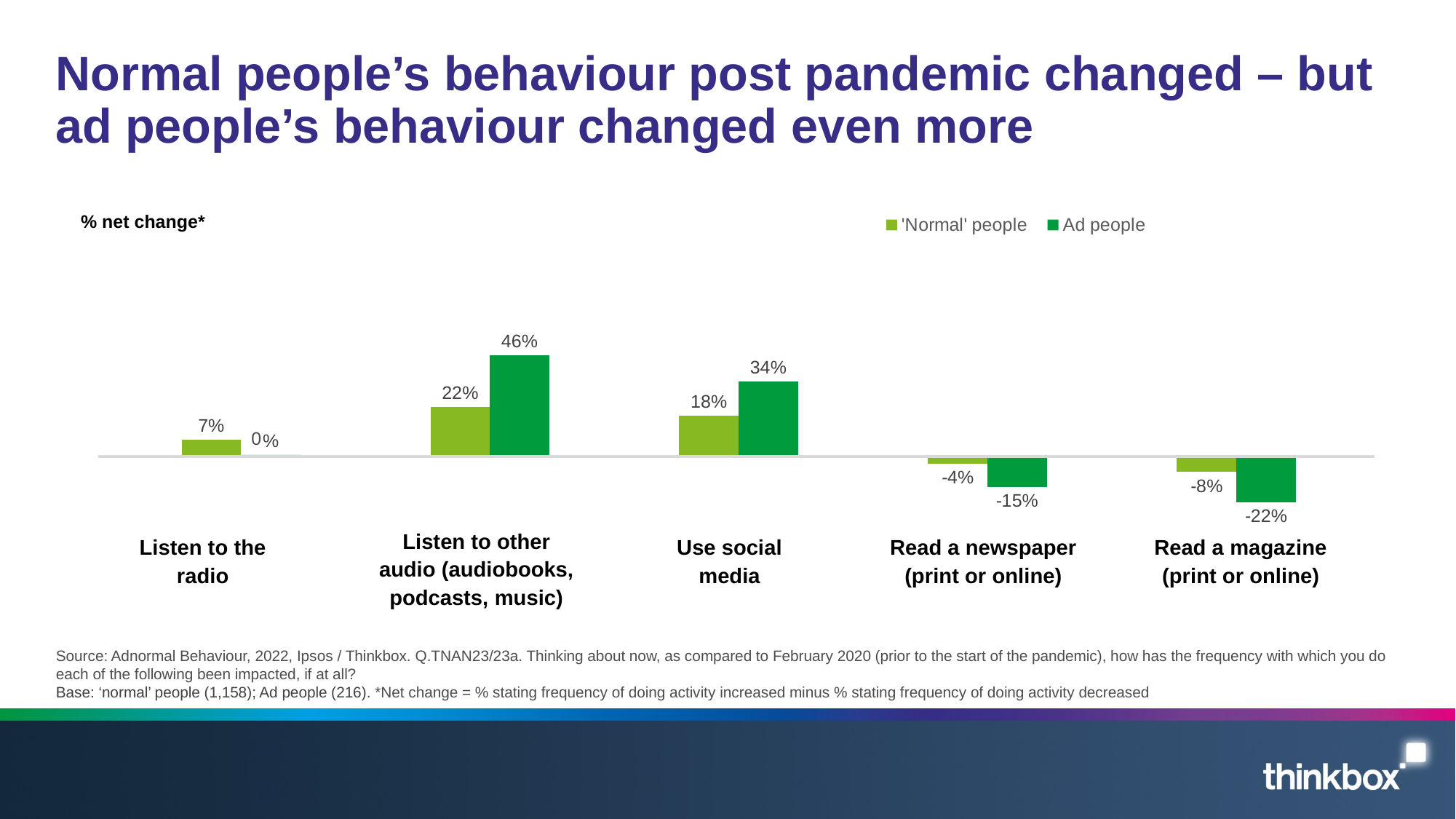
What kind of chart is shown on the slide? Bar chart For 'Read a newspaper (print or online)', which group has the larger % net change: 'Normal' people or Ad people? 'Normal' people What is the % net change for Ad people for 'Read a magazine (print or online)'? -22% How many categories are shown on the x axis of the chart? 5 What are the two series named in the chart legend? 'Normal' people and Ad people What is the % net change for 'Normal' people for 'Listen to the radio'? 7% What is the % net change for Ad people for 'Use social media'? 34% Which category has the highest % net change for Ad people? Listen to other audio (audiobooks, podcasts, music) What is the difference between the Ad people and 'Normal' people values for 'Listen to other audio (audiobooks, podcasts, music)'? 24 percentage points Which category has the lowest % net change for 'Normal' people? Read a magazine (print or online) What is the % net change for 'Normal' people for 'Listen to other audio (audiobooks, podcasts, music)'? 22% How many series does the legend list? 2